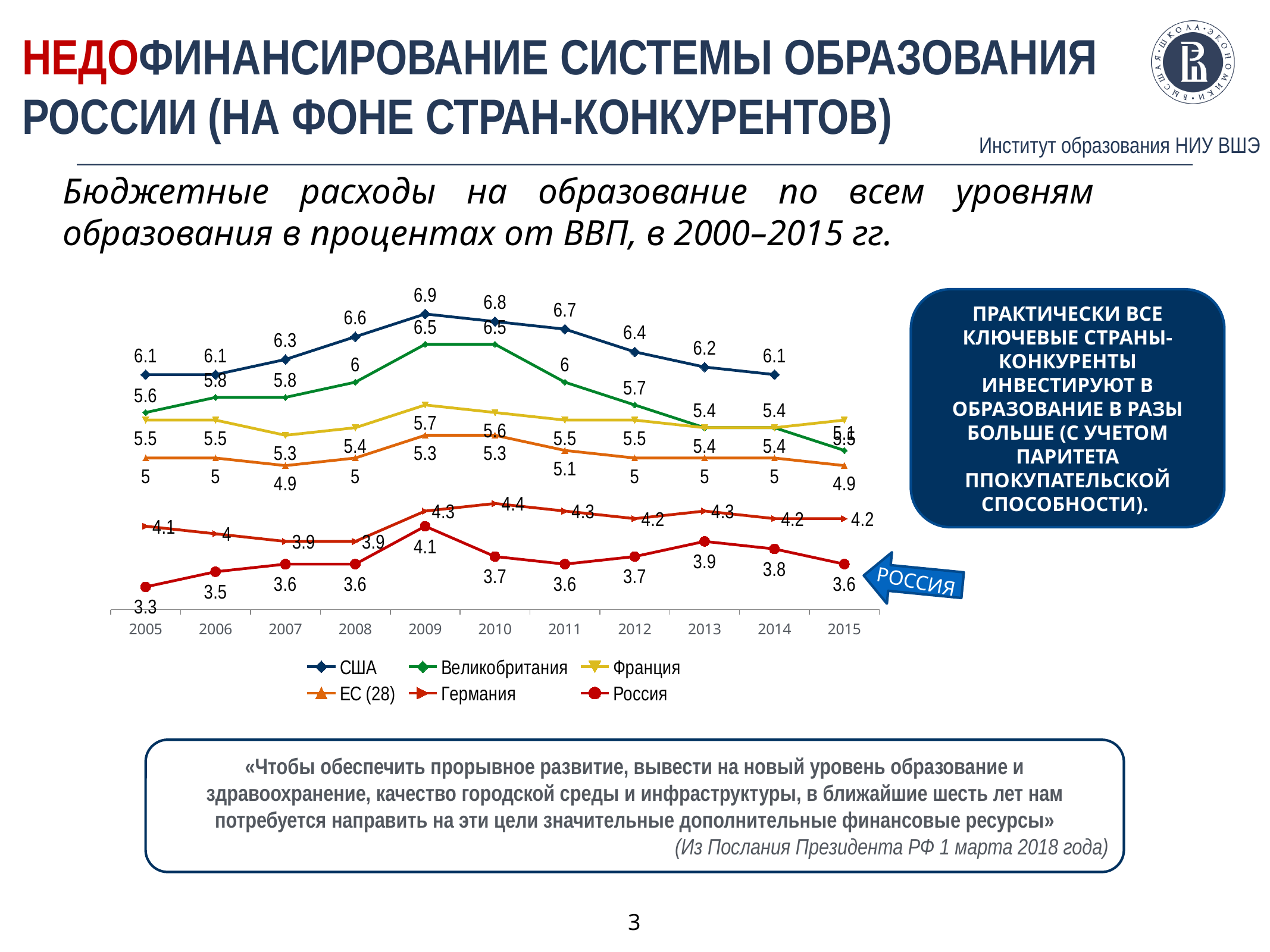
Does the Россия series rise or fall from 2005 to 2009? rise What is the value for Россия in 2009? 4.1 What kind of chart is shown on the slide? line chart In which year does the Россия series have its lowest value? 2005 How many series does the legend list? 6 What is the value for Великобритания in 2015? 5.1 What is the value for США in 2009? 6.9 What is the difference between the США value and the Россия value in 2009? 2.8 What is the value for Германия in 2010? 4.4 In which year does the Россия series reach its highest value? 2009 Which is larger in 2015: the value for Германия or the value for Россия? Германия How many years are shown on the x axis? 11